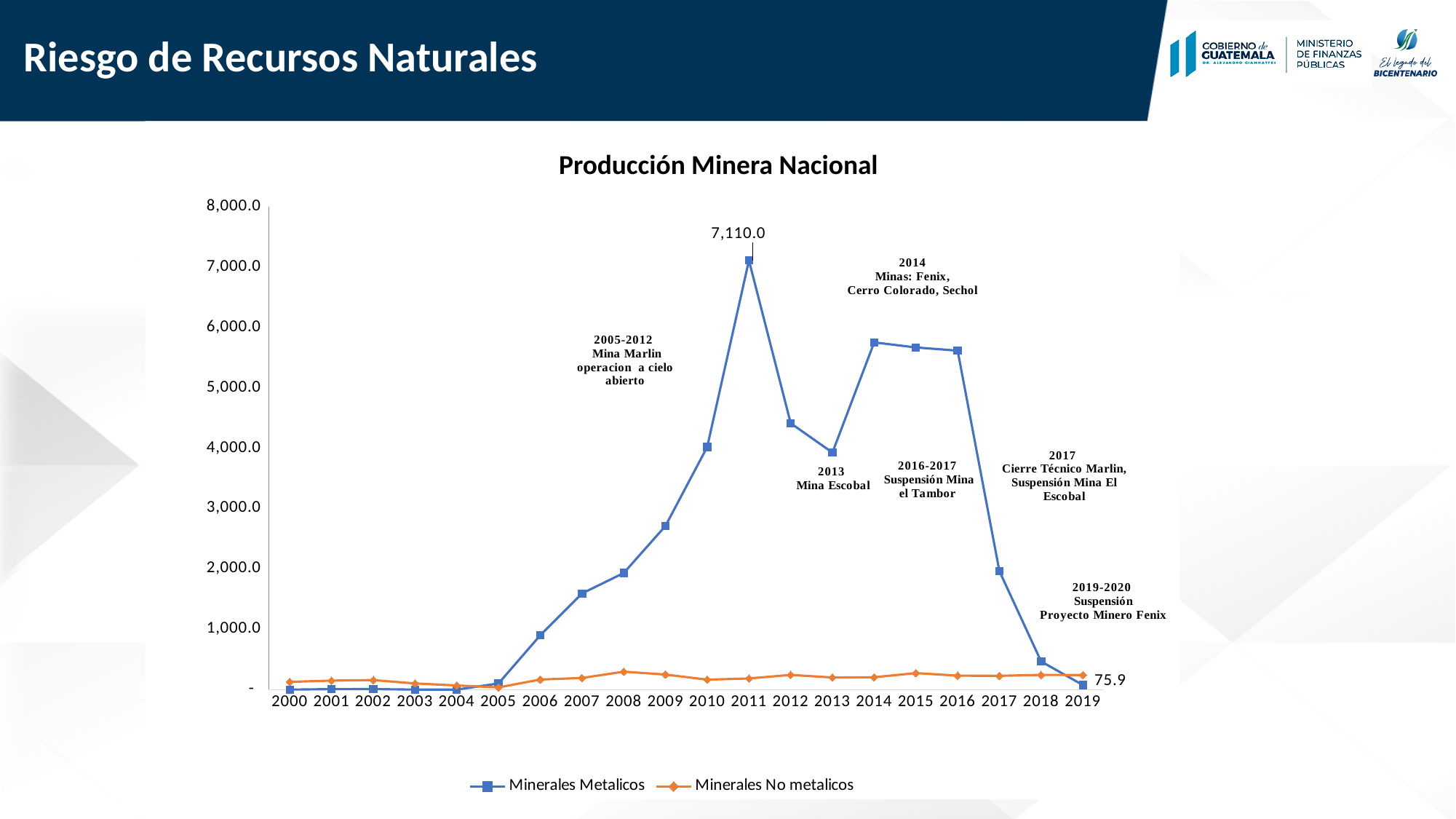
What kind of chart is shown on the slide? line chart What is the value of Minerales Metalicos in 2011? 7,110.0 In 2011, which series has the larger value, Minerales Metalicos or Minerales No metalicos? Minerales Metalicos What is the difference between the Minerales Metalicos value in 2011 and in 2019? 7,034.1 Is the value for Minerales Metalicos in 2018 greater or less than 1,000.0? less Is the value for Minerales Metalicos in 2014 greater or less than 5,000.0? greater What is the title of the chart? Producción Minera Nacional How many years are plotted along the x axis? 20 What is the value of Minerales Metalicos in 2019? 75.9 How many series does the legend list? 2 In which year does Minerales Metalicos reach its highest value? 2011 Does the Minerales Metalicos line rise or fall from 2016 to 2019? fall